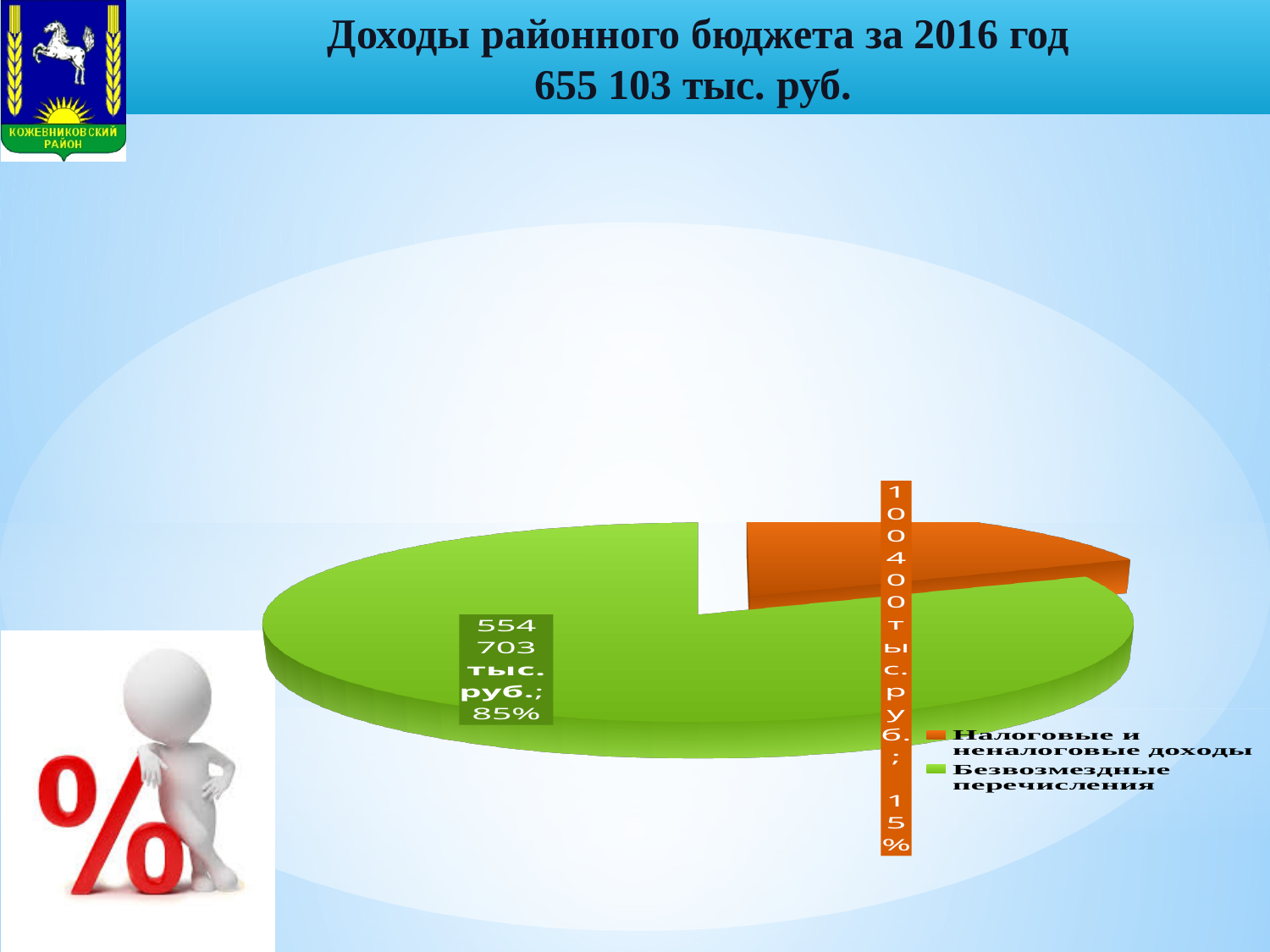
How many entries does the legend list? 2 What value is shown for Налоговые и неналоговые доходы? 100 400 тыс. руб. Which category has the smallest slice of the pie? Налоговые и неналоговые доходы Which is larger: Безвозмездные перечисления or Налоговые и неналоговые доходы? Безвозмездные перечисления What colour is the slice for Налоговые и неналоговые доходы? orange How many slices does the pie chart have? 2 What is the difference between Безвозмездные перечисления and Налоговые и неналоговые доходы in тыс. руб.? 454 303 тыс. руб. What share of the pie does Безвозмездные перечисления represent? 85% What kind of chart is shown on the slide? pie chart What value is shown for Безвозмездные перечисления? 554 703 тыс. руб. Which category has the largest slice of the pie? Безвозмездные перечисления What share of the pie does Налоговые и неналоговые доходы represent? 15%